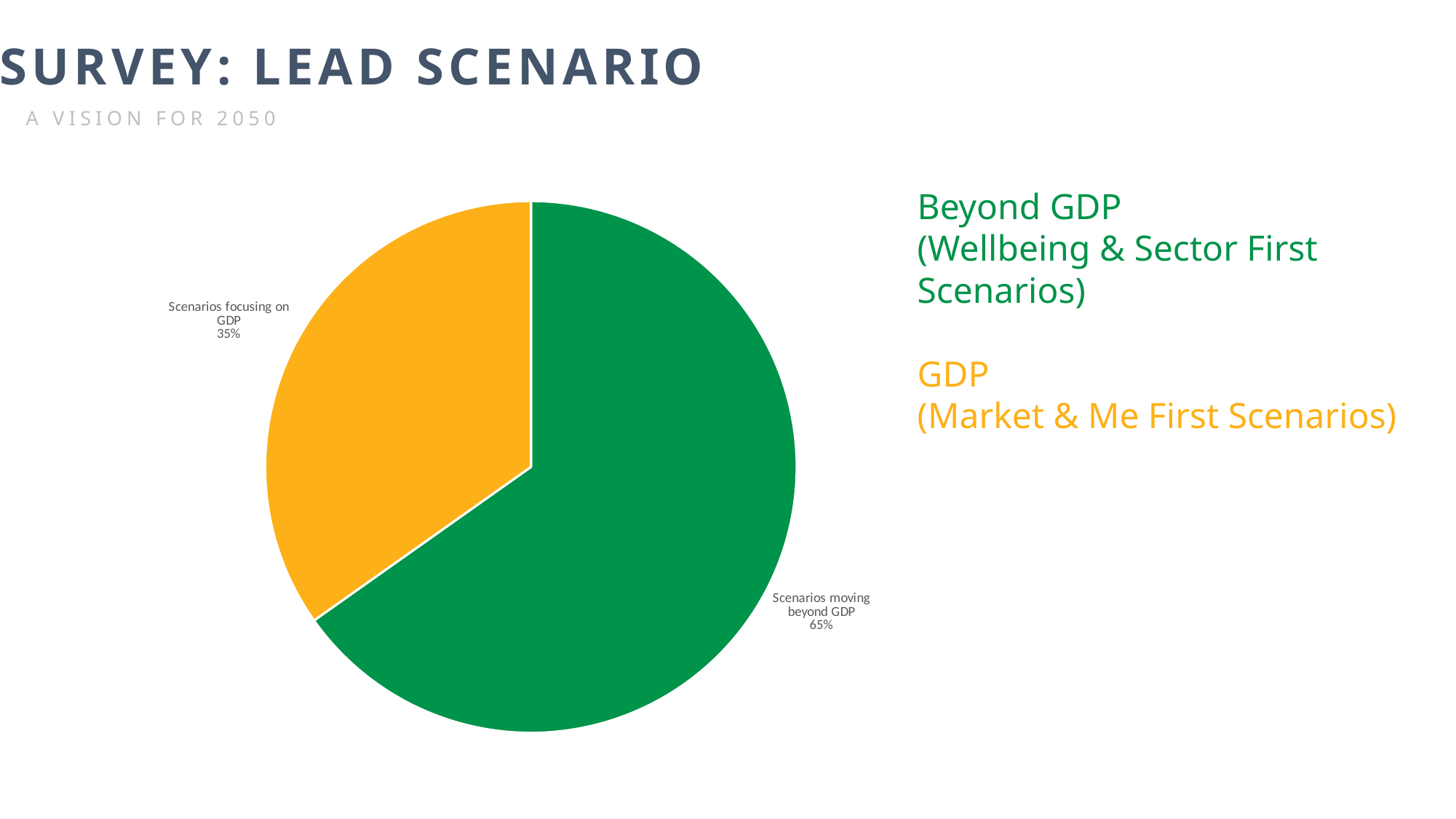
Which slice of the pie is the largest? Scenarios moving beyond GDP What is the difference in percentage points between the "Scenarios moving beyond GDP" slice and the "Scenarios focusing on GDP" slice? 30 percentage points What share of the pie is labelled "Scenarios focusing on GDP"? 35% What share of the pie is labelled "Scenarios moving beyond GDP"? 65% How many slices does the pie chart have? 2 What kind of chart is shown on the slide? pie chart Which is larger: the share for "Scenarios focusing on GDP" or the share for "Scenarios moving beyond GDP"? Scenarios moving beyond GDP What is the total of the two slices shown in the pie chart? 100% What colour is the "Scenarios moving beyond GDP" slice? green Which slice of the pie is the smallest? Scenarios focusing on GDP What colour is the "Scenarios focusing on GDP" slice? orange